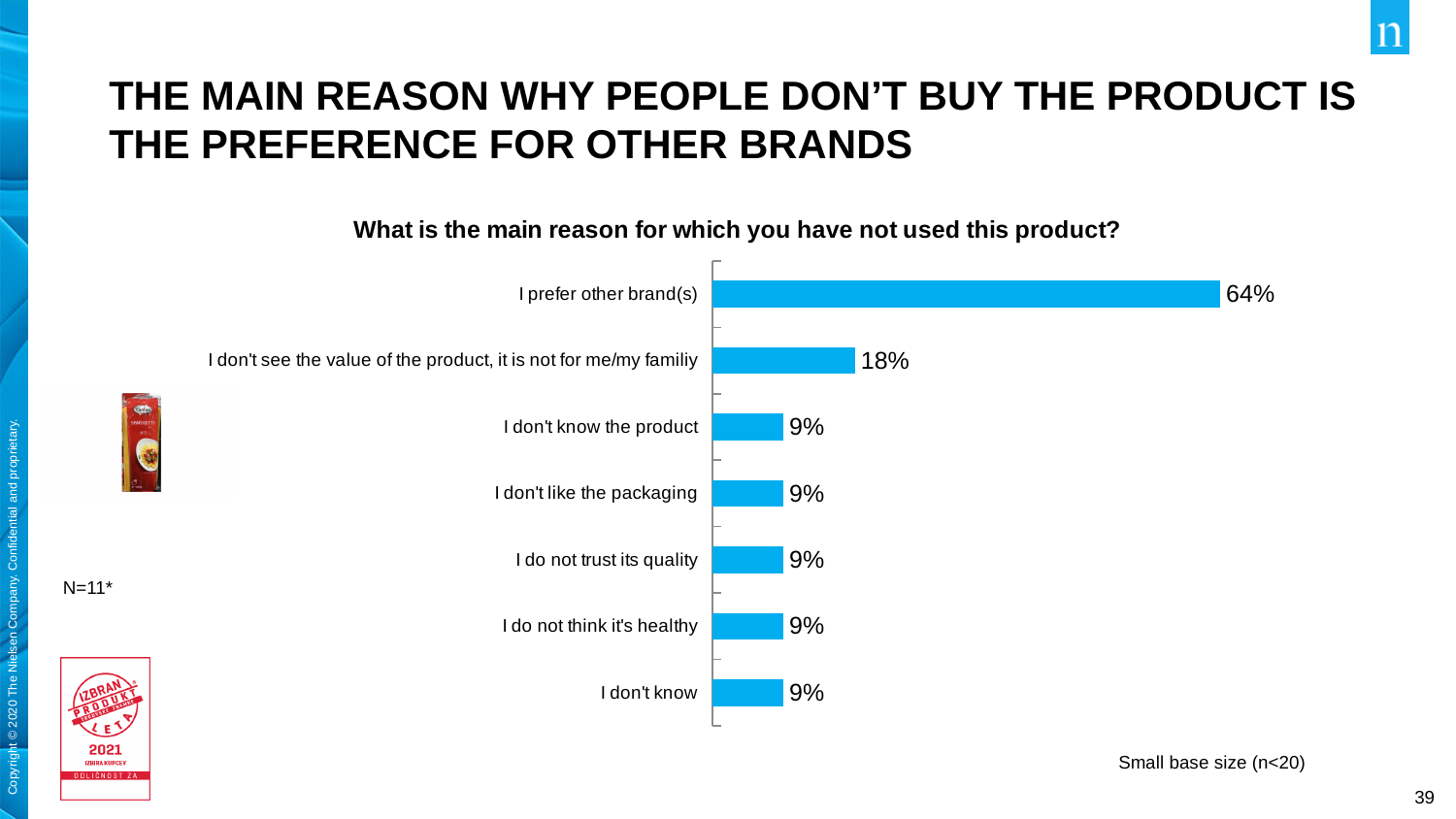
Which reason has the highest percentage? I prefer other brand(s) What percentage of respondents said "I prefer other brand(s)" as the main reason for not using the product? 64% How many categories share the value of 9%? 5 What percentage of respondents answered "I don't know the product"? 9% Which is larger: the value for "I don't see the value of the product, it is not for me/my familiy" or the value for "I do not think it's healthy"? I don't see the value of the product, it is not for me/my familiy What kind of chart is shown on the slide? Bar chart How many reasons (categories) are shown in the chart? 7 What is the value for "I don't like the packaging"? 9% What is the difference between "I don't see the value of the product, it is not for me/my familiy" and "I do not trust its quality"? 9 percentage points What is the difference between "I prefer other brand(s)" and "I don't see the value of the product, it is not for me/my familiy"? 46 percentage points What is the value for "I don't see the value of the product, it is not for me/my familiy"? 18% What question is the chart based on, as shown in its title? What is the main reason for which you have not used this product?